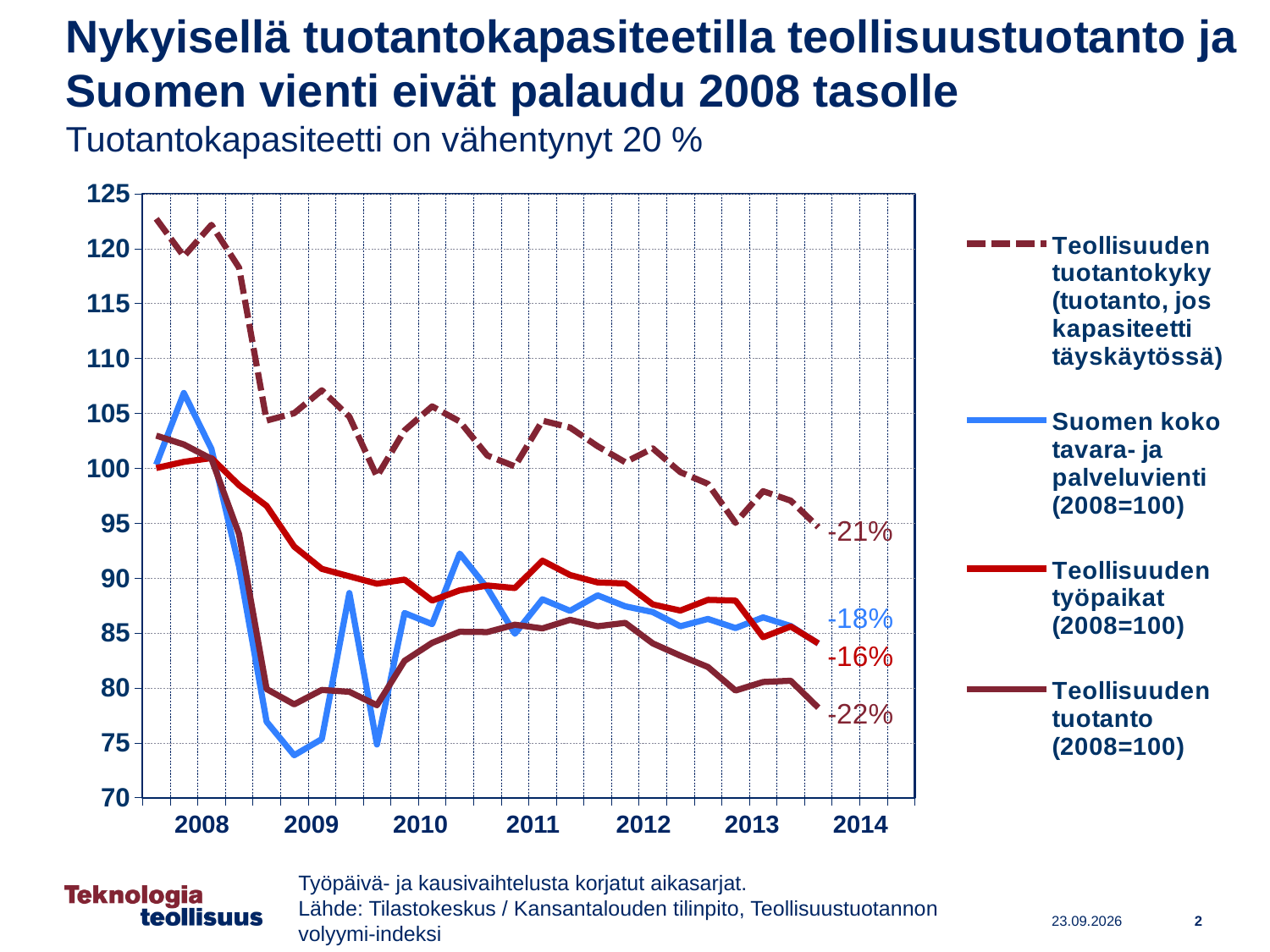
How many percentage points larger is the decline of Teollisuuden tuotanto (-22%) than that of Teollisuuden työpaikat (-16%)? 6 Is the value of Teollisuuden tuotantokyky at the start of 2008 greater or less than 120? greater What percentage change is labelled at the end of the Teollisuuden tuotanto (2008=100) line? -22% Does the Teollisuuden tuotantokyky line generally rise or fall from 2008 to 2014? fall What percentage change is labelled at the end of the Teollisuuden työpaikat (2008=100) line? -16% What percentage change is labelled at the end of the Suomen koko tavara- ja palveluvienti (2008=100) line? -18% What kind of chart is shown on the slide? line chart Which series shows the largest percentage decline according to the labels at the right end of the lines? Teollisuuden tuotanto (2008=100) Which series shows the smallest percentage decline according to the labels at the right end of the lines? Teollisuuden työpaikat (2008=100) What percentage change is labelled at the end of the Teollisuuden tuotantokyky line? -21% How many series does the legend list? 4 Which series is drawn with a dashed line? Teollisuuden tuotantokyky (tuotanto, jos kapasiteetti täyskäytössä)